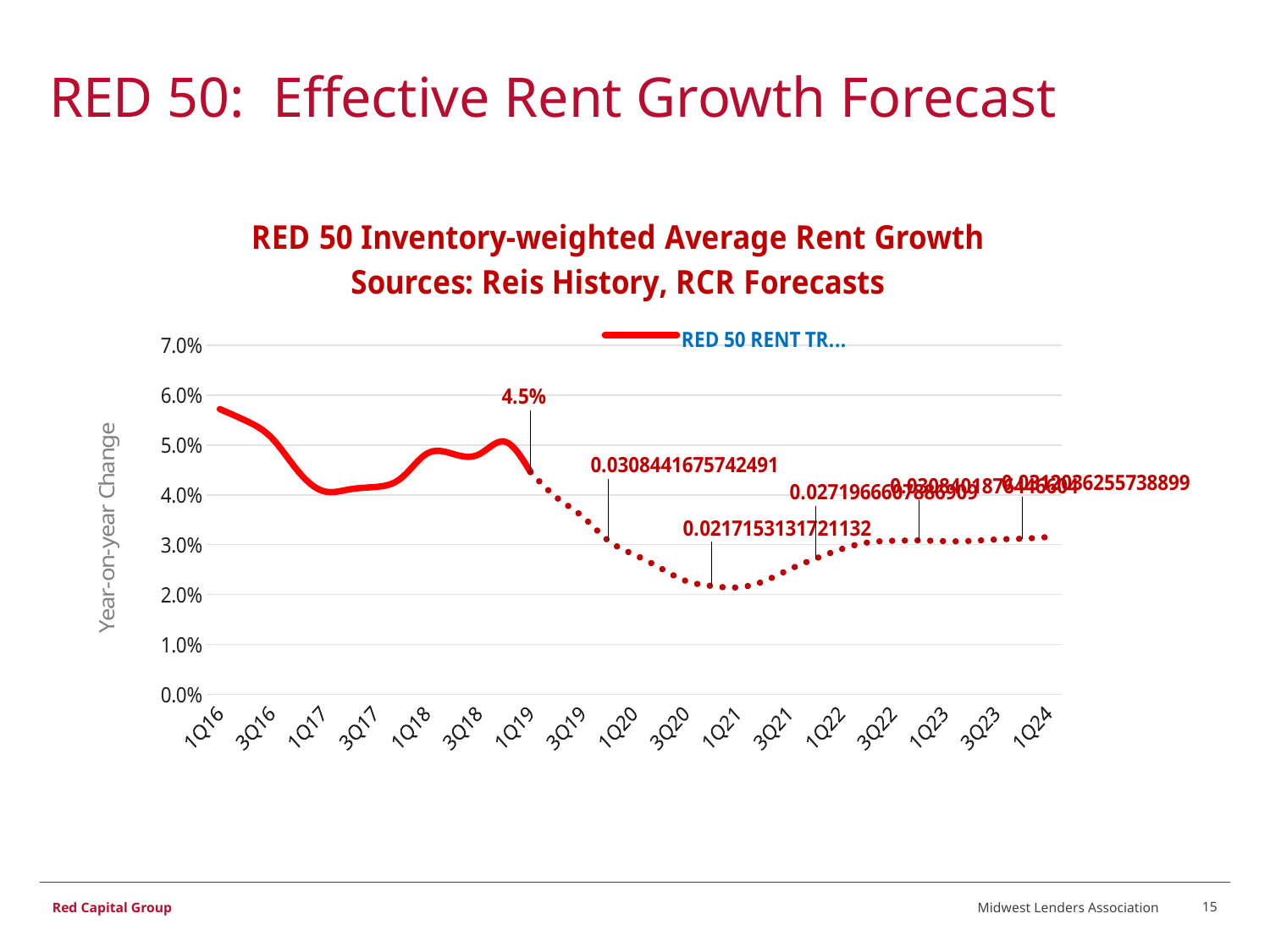
Does the line rise or fall from 1Q19 to 1Q21? fall What is the title of the vertical axis? Year-on-year Change What is the value labelled at 1Q19? 4.5% Which is larger, the value for 1Q16 or the value for 1Q21? 1Q16 Is the value for 3Q20 greater or less than 3.0%? less Is the value for 1Q16 greater or less than 5.0%? greater Does the line rise or fall from 1Q16 to 1Q17? fall What kind of chart is shown on the slide? line chart Which quarter has the highest value on the chart? 1Q16 Is the value for 1Q17 greater or less than 5.0%? less